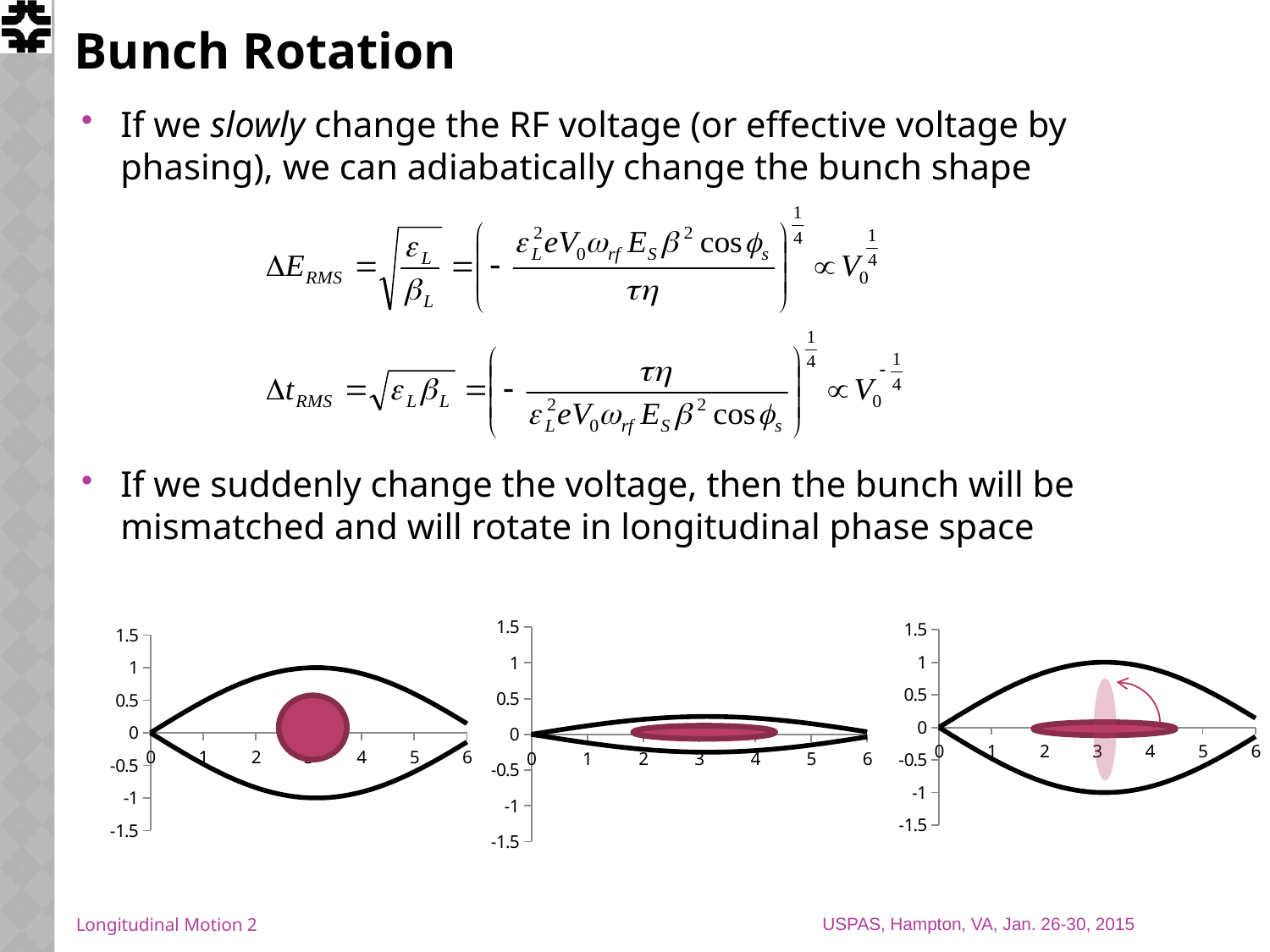
How many charts are shown on the slide? 3 What kind of chart is the leftmost chart at the bottom of the slide? line chart What is the largest value labelled on the x axis of the middle chart? 6 In the rightmost chart, does the upper curve rise or fall as x goes from 3 to 6? fall In the leftmost chart, is the peak value of the upper curve greater or less than 0.5? greater What is the highest value labelled on the y axis of the leftmost chart? 1.5 In the leftmost chart, is the lowest value of the lower curve greater or less than -0.5? less In the middle chart, is the lowest value of the lower curve greater or less than -0.5? greater In the leftmost chart, does the upper curve rise or fall as x goes from 0 to 3? rise Which chart has the smaller peak of its upper curve, the leftmost chart or the middle chart? the middle chart